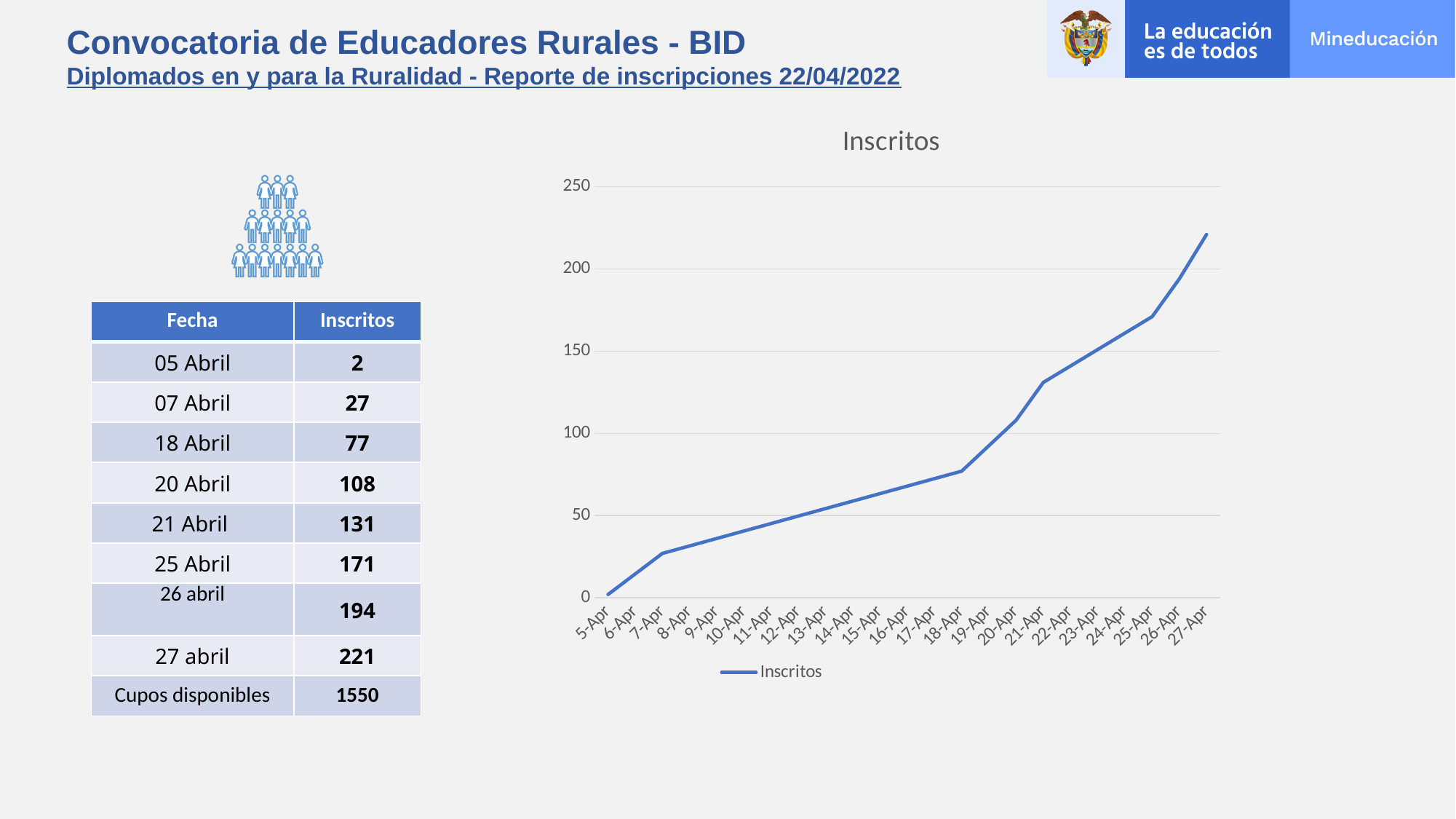
Which date has the highest value in the Inscritos chart? 27-Apr How many series does the legend of the Inscritos chart list? 1 In the Inscritos chart, which is larger, the value for 26-Apr or the value for 20-Apr? 26-Apr What kind of chart is shown on the slide? line chart In the Inscritos chart, is the value for 18-Apr greater or less than 100? less According to the table on the slide, how many Inscritos were there on 27 abril? 221 Do the values in the Inscritos chart rise or fall from 5-Apr to 27-Apr? rise How many dates are shown on the x axis of the Inscritos chart? 23 In the Inscritos chart, is the value for 25-Apr greater or less than 150? greater What is the title of the chart on the slide? Inscritos In the Inscritos chart, is the value for 27-Apr greater or less than 200? greater Which date has the lowest value in the Inscritos chart? 5-Apr